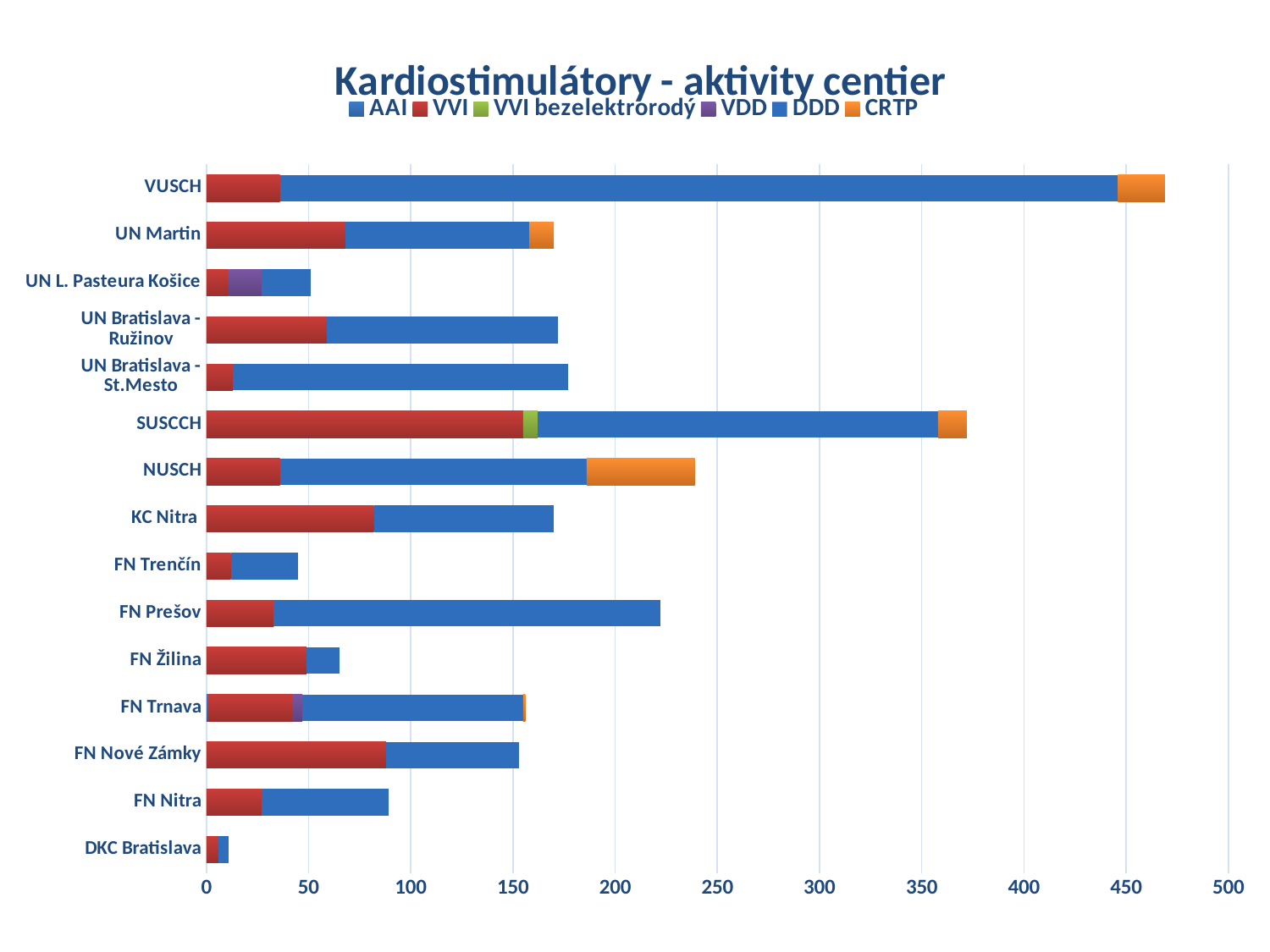
What is the title of the chart? Kardiostimulátory - aktivity centier Which centre has the shortest total bar in the chart? DKC Bratislava Which centre has a longer total bar, FN Prešov or KC Nitra? FN Prešov Which centre has the longest total bar in the chart? VUSCH What kind of chart is shown on the slide? stacked bar chart Is the total bar length for FN Trenčín greater or less than 50? less Is the total bar length for NUSCH greater or less than 250? less How many centres (categories) are listed on the vertical axis of the chart? 15 How many series does the chart legend list? 6 Is the total bar length for SUSCCH greater or less than 350? greater Which centre has a longer total bar, VUSCH or SUSCCH? VUSCH